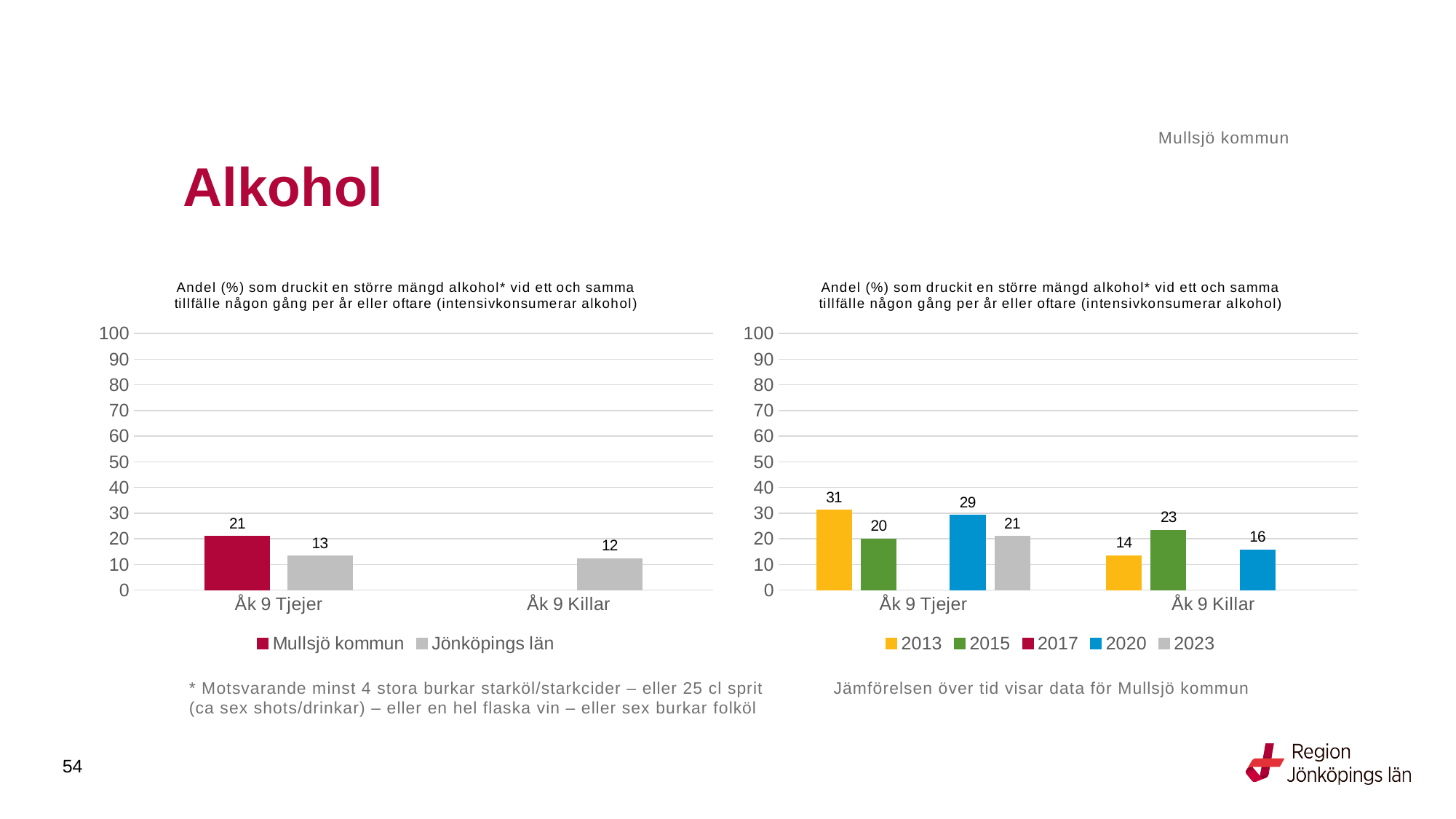
In the right chart, which year has the lowest value for Åk 9 Killar? 2013 In the right chart, how many series does the legend list? 5 In the left chart, what is the value for Jönköpings län for Åk 9 Killar? 12 In the right chart, what is the value for 2015 for Åk 9 Killar? 23 In the right chart, what is the difference between the 2020 and 2023 values for Åk 9 Tjejer? 8 In the right chart, is the 2020 value for Åk 9 Tjejer larger or smaller than the 2015 value for Åk 9 Tjejer? larger In the left chart, what is the difference between Mullsjö kommun and Jönköpings län for Åk 9 Tjejer? 8 In the right chart, what is the value for 2013 for Åk 9 Tjejer? 31 In the right chart, which year has the highest value for Åk 9 Tjejer? 2013 In the left chart, what is the value for Mullsjö kommun for Åk 9 Tjejer? 21 In the left chart, how many series does the legend list? 2 What kind of chart is the right chart? bar chart